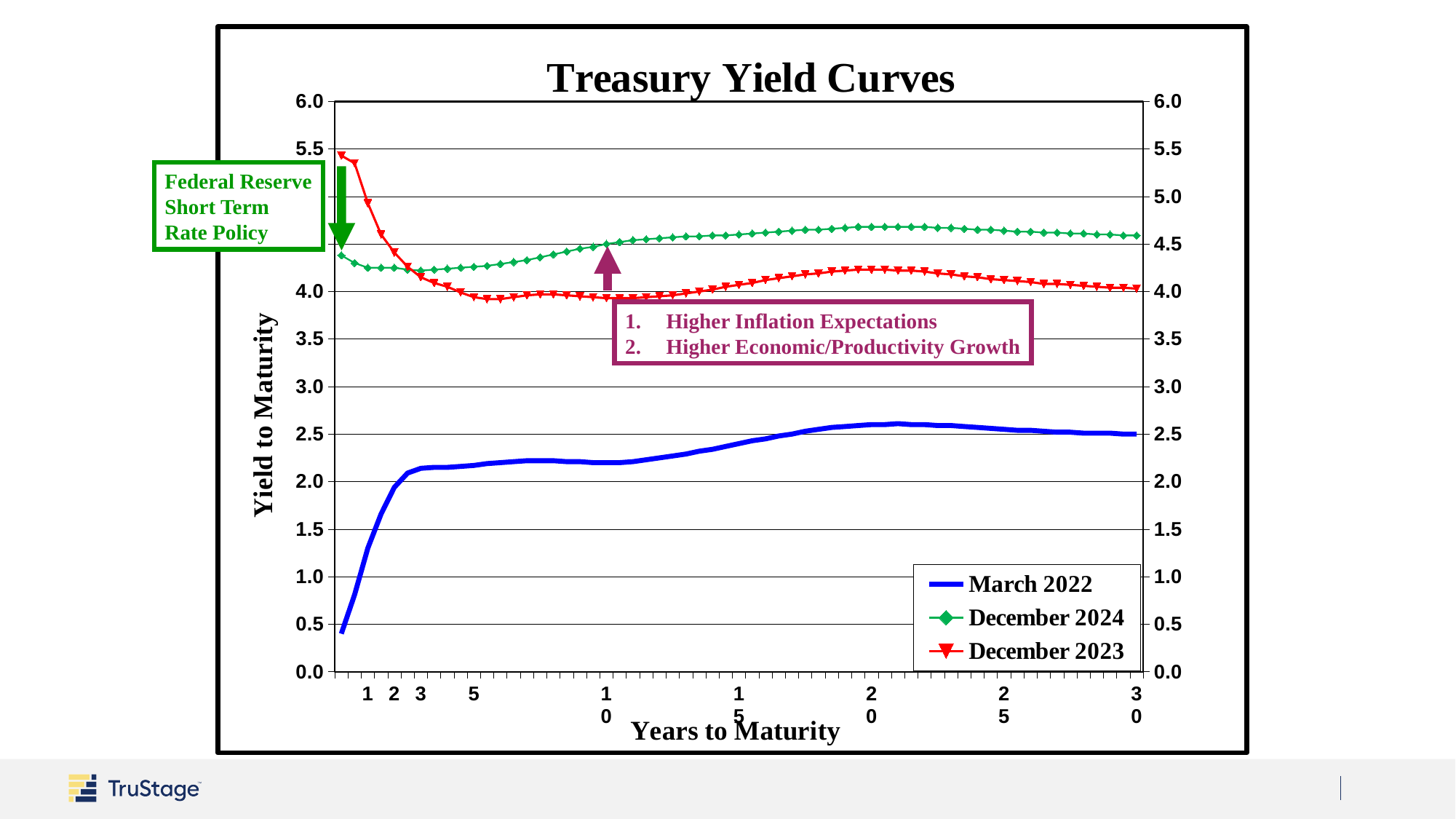
What kind of chart is shown on the slide? line chart Does the March 2022 curve rise or fall between 1 and 10 years to maturity? rise Which series has the highest yield at the shortest maturity? December 2023 What is the title of the chart? Treasury Yield Curves At 1 year to maturity, which is higher: December 2023 or December 2024? December 2023 Is the March 2022 yield at 10 years to maturity greater or less than 2.5? less How many series does the legend list? 3 At 30 years to maturity, which is higher: December 2024 or December 2023? December 2024 Does the December 2023 curve rise or fall between 1 and 5 years to maturity? fall What is the label of the y axis? Yield to Maturity Which series has the lowest yields across all maturities? March 2022